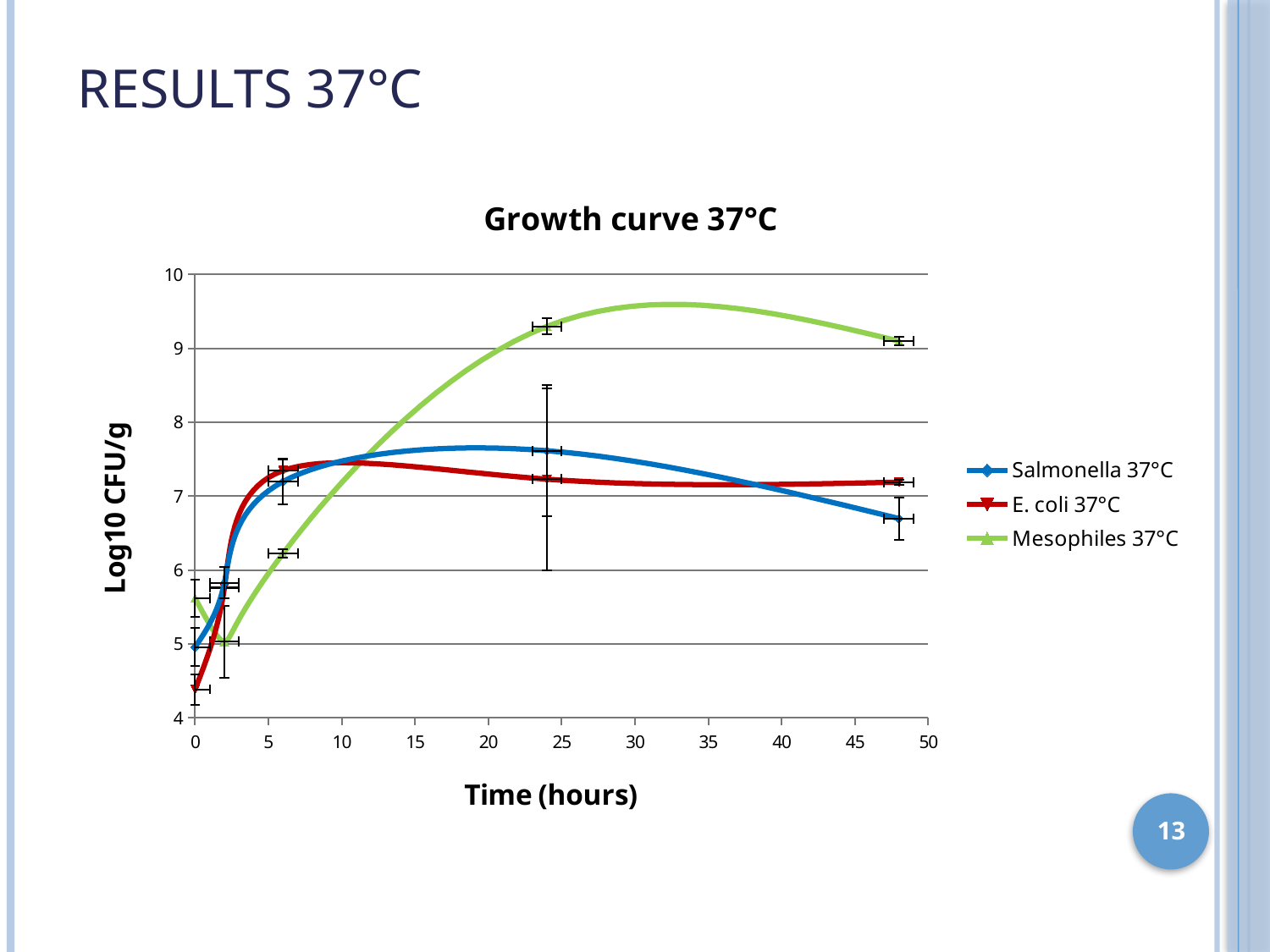
How many series does the legend of the Growth curve 37°C chart list? 3 What is the label of the y axis of the chart? Log10 CFU/g At 48 hours, which series has the higher value: Mesophiles 37°C or Salmonella 37°C? Mesophiles 37°C Is the value for E. coli 37°C at 0 hours greater or less than 5? less Is the value for Salmonella 37°C at 48 hours greater or less than 7? less At 0 hours, which series has the higher value: Mesophiles 37°C or E. coli 37°C? Mesophiles 37°C Is the value for Mesophiles 37°C at 24 hours greater or less than 9? greater Which series reaches the highest Log10 CFU/g value on the chart? Mesophiles 37°C What kind of chart is shown on the slide? line chart What is the title of the chart on the slide? Growth curve 37°C Does the Salmonella 37°C curve rise or fall between 24 and 48 hours? fall